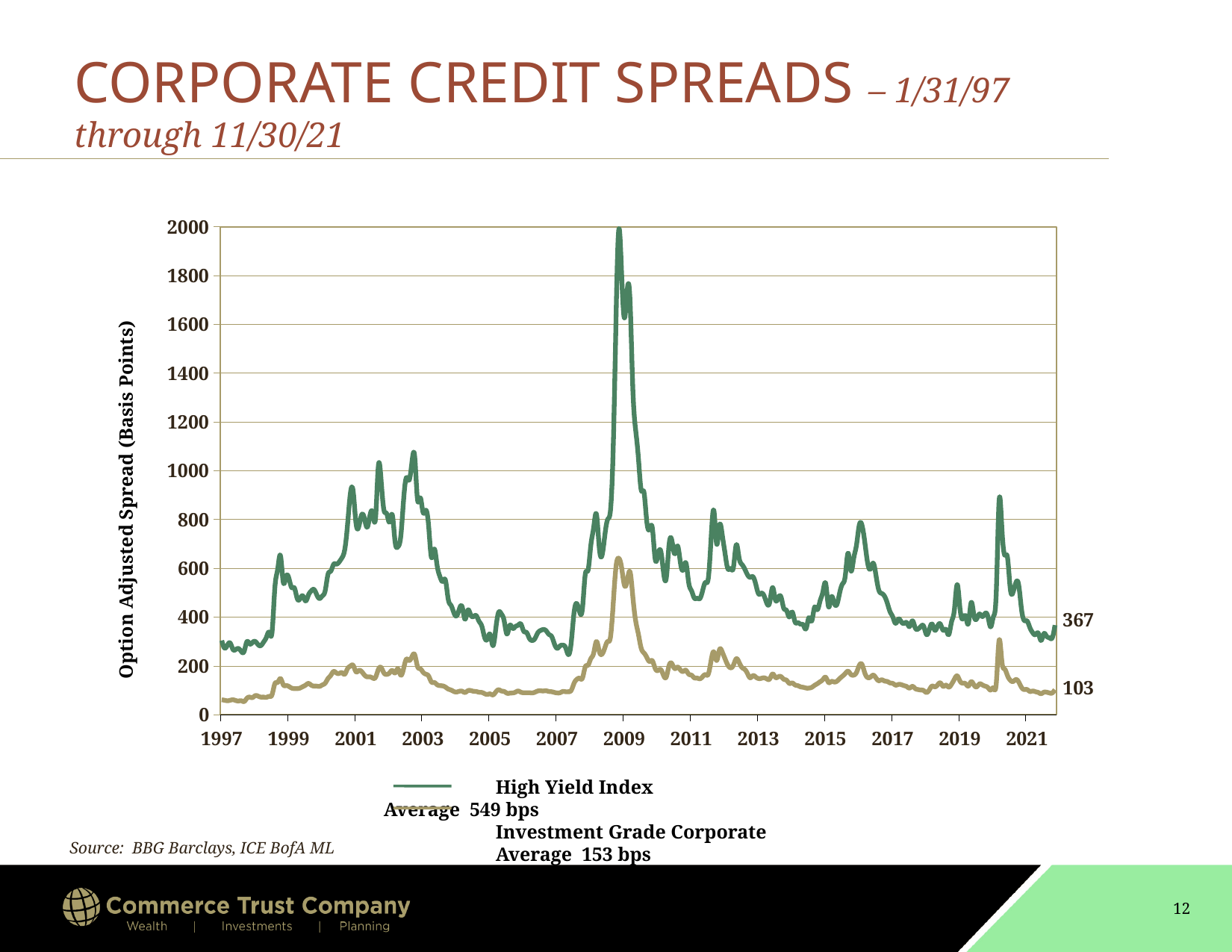
Is the peak value of the High Yield Index around 2009 greater or less than 1800? greater What average is stated in the legend for Investment Grade Corporate? 153 bps How many series does the legend list? 2 What is the difference between the final labeled values of the High Yield Index (367) and Investment Grade Corporate (103) series? 264 What is the final labeled value of the High Yield Index series at the right end of the chart? 367 Is the peak value of the Investment Grade Corporate series around 2009 greater or less than 800? less What type of chart is shown on the slide? line chart Which series has the higher final labeled value, High Yield Index or Investment Grade Corporate? High Yield Index What is the label of the y axis? Option Adjusted Spread (Basis Points) What average is stated in the legend for the High Yield Index? 549 bps What is the final labeled value of the Investment Grade Corporate series at the right end of the chart? 103